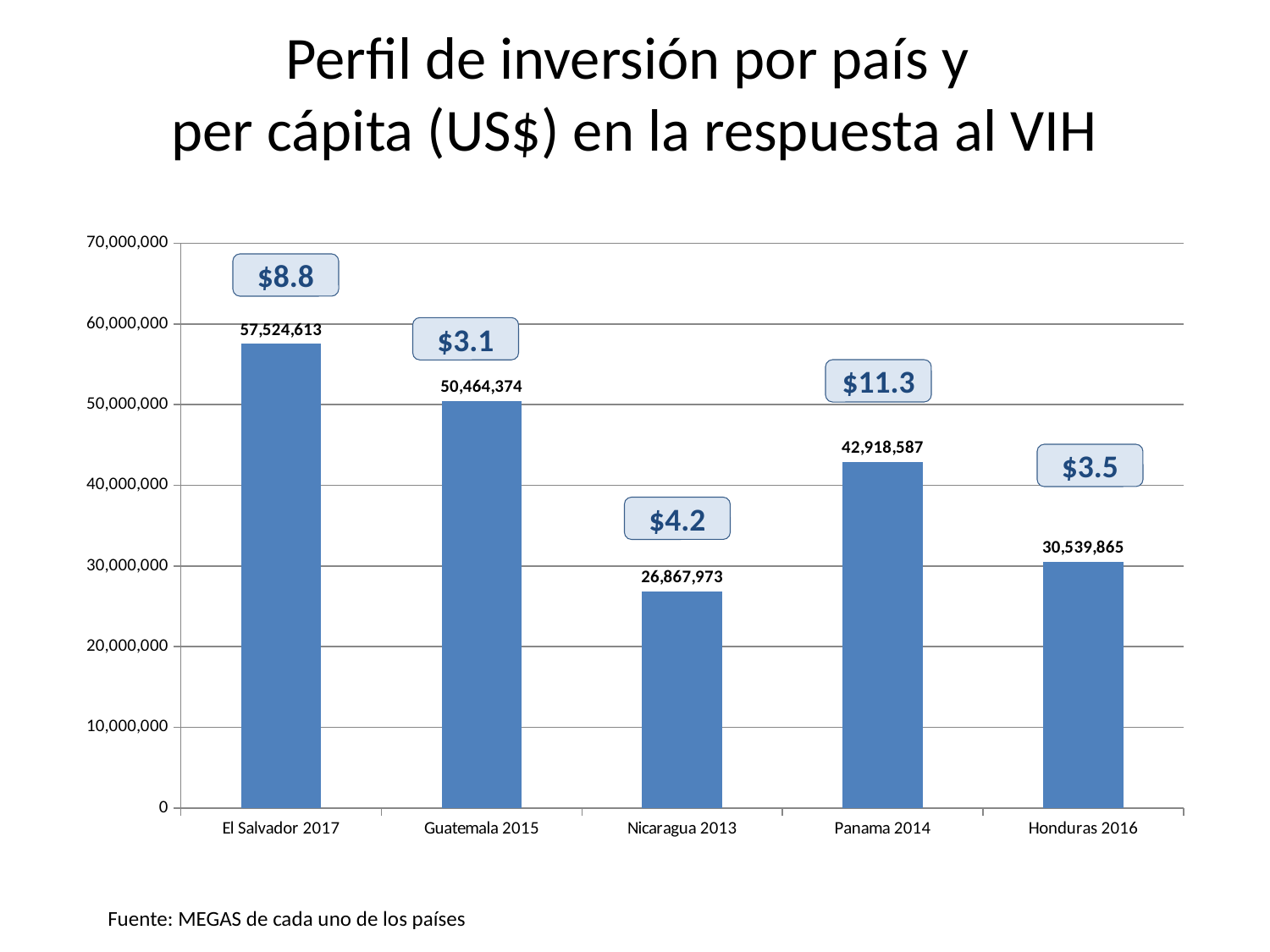
Which has a larger investment value, Honduras 2016 or Nicaragua 2013? Honduras 2016 What is the investment value shown for El Salvador 2017? 57,524,613 What per capita value (US$) is shown in the callout above Panama 2014? $11.3 How many countries are shown on the chart? 5 What is the difference between the investment values for Panama 2014 and Honduras 2016? 12,378,722 Which country has the highest total investment bar? El Salvador 2017 Is the investment value for Panama 2014 greater or less than 40,000,000? greater Which country has the lowest total investment bar? Nicaragua 2013 What per capita value (US$) is shown in the callout above Guatemala 2015? $3.1 What is the investment value shown for Nicaragua 2013? 26,867,973 What type of chart is shown on the slide? Bar chart What is the difference between the investment values for El Salvador 2017 and Guatemala 2015? 7,060,239